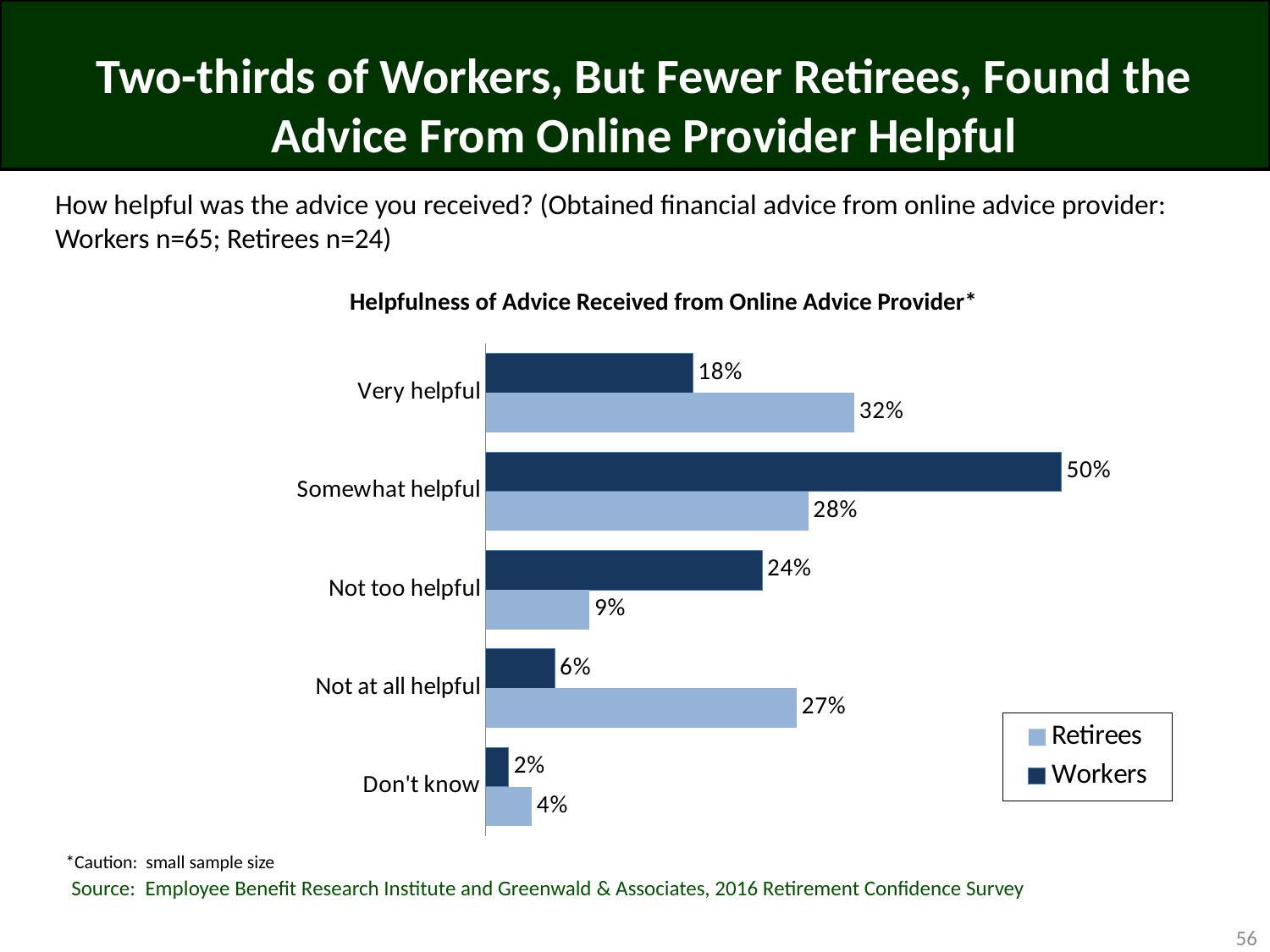
What is the title of the chart? Helpfulness of Advice Received from Online Advice Provider* What kind of chart is shown on the slide? Bar chart What percentage of Retirees found the advice not at all helpful? 27% How many response categories are shown on the chart? 5 Which category has the lowest value for Retirees? Don't know How many series does the legend list? 2 What percentage of Workers found the advice somewhat helpful? 50% What percentage of Retirees found the advice very helpful? 32% Which series is shown in the darker blue colour? Workers Which category has the highest value for Workers? Somewhat helpful What is the difference between the Workers and Retirees values for 'Not too helpful'? 15% For 'Very helpful', which group has the larger value, Workers or Retirees? Retirees